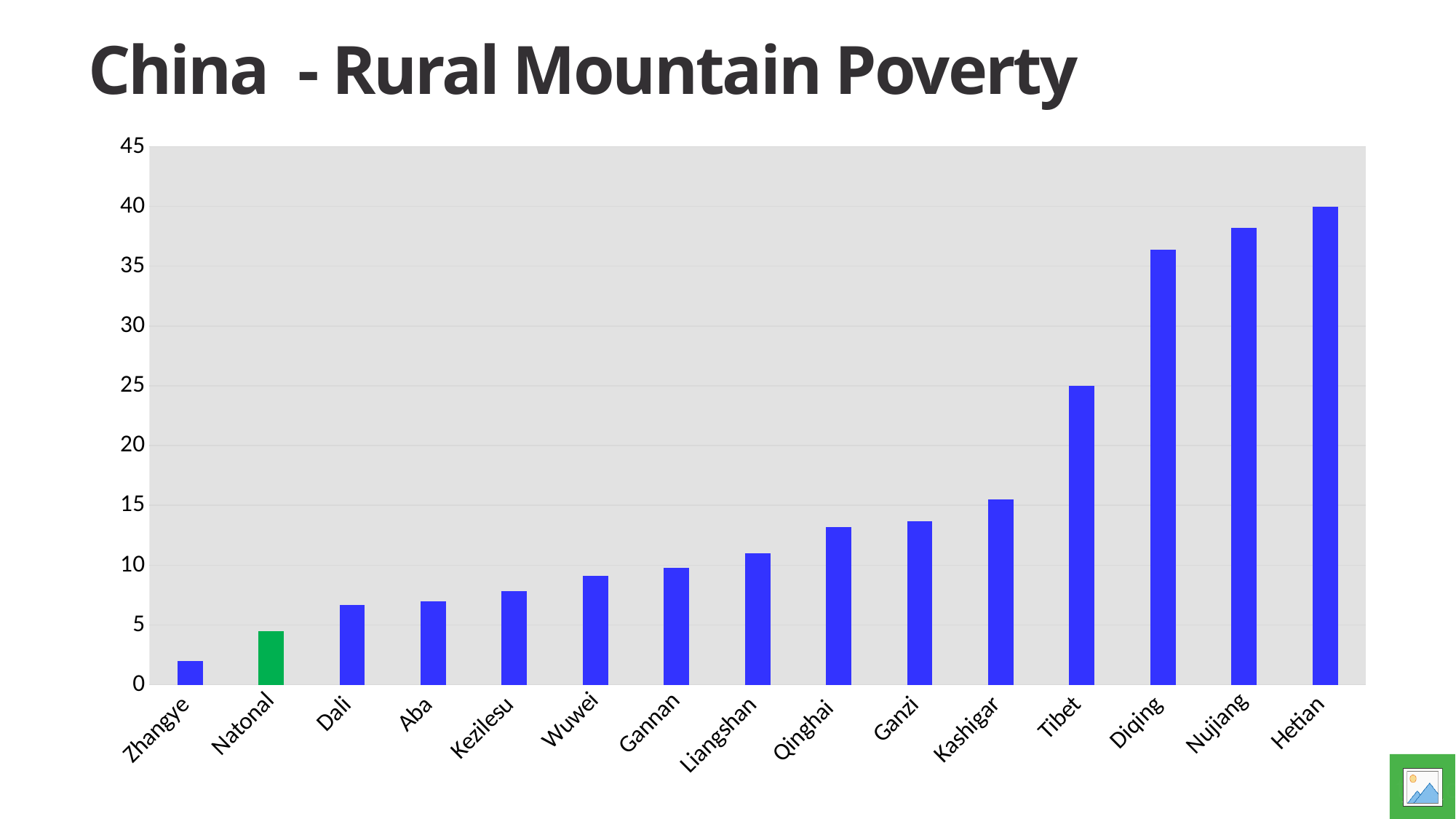
What kind of chart is shown on the slide? bar chart Which category has the lowest bar? Zhangye Is the value for Tibet greater or less than 20? greater Which is larger, the value for Diqing or the value for Tibet? Diqing Do the bar values generally rise or fall from left to right along the x axis? rise Which category is shown with a green bar instead of a blue one? Natonal How many categories are plotted on the x axis? 15 Which category has the highest bar? Hetian Is the value for Kashigar greater or less than 20? less What is the title of the chart? China - Rural Mountain Poverty Is the value for Hetian greater or less than 35? greater